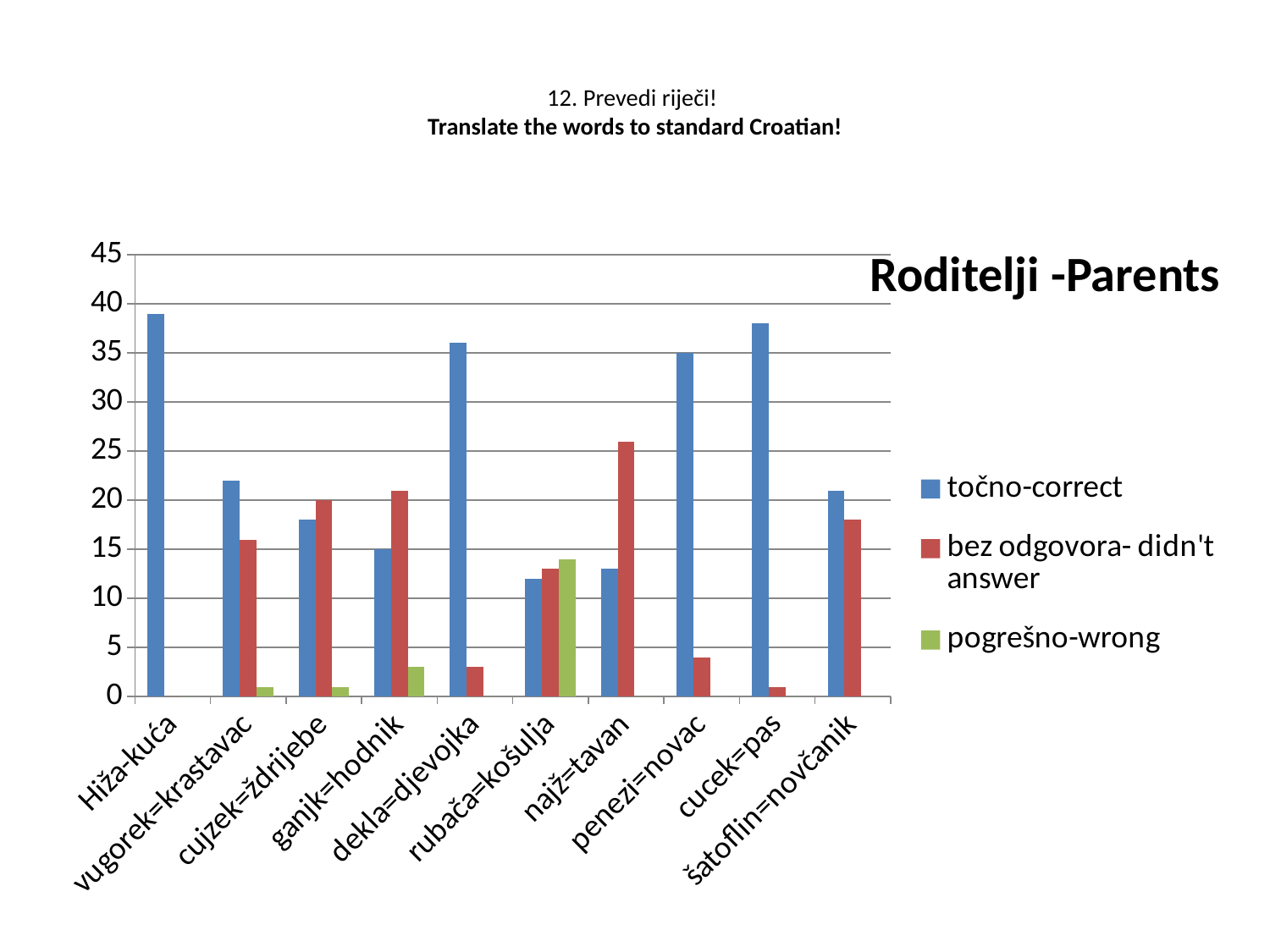
Which category has the highest 'pogrešno-wrong' value? rubača=košulja What is the title of the chart? Roditelji -Parents Which category has the highest 'bez odgovora- didn't answer' value? najž=tavan Is the 'bez odgovora- didn't answer' value for najž=tavan greater or less than 20? greater For najž=tavan, which is larger: 'točno-correct' or 'bez odgovora- didn't answer'? bez odgovora- didn't answer Which colour represents the 'pogrešno-wrong' series? green How many series does the legend list? 3 Is the 'točno-correct' value for rubača=košulja greater or less than 15? less Which has the larger 'točno-correct' value: vugorek=krastavac or cujzek=ždrijebe? vugorek=krastavac What type of chart is shown on the slide? bar chart Is the 'točno-correct' value for Hiža-kuća greater or less than 35? greater How many word categories are shown on the x axis? 10